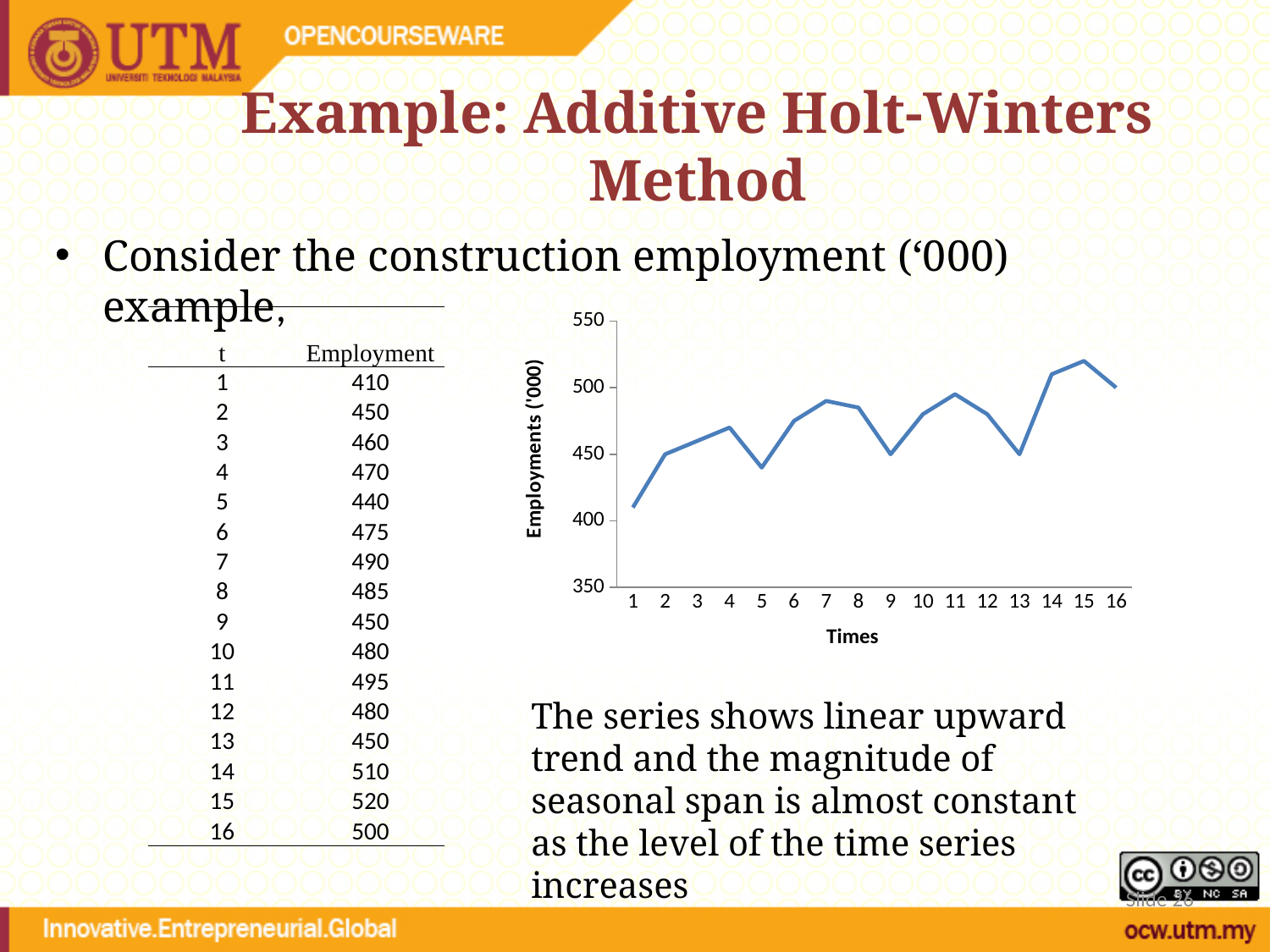
What is the employment value at t = 1? 410 Which has the larger employment value, t = 7 or t = 5? t = 7 Is the value at t = 15 greater or less than 500? greater How many time points are plotted on the chart? 16 What is the difference between the employment value at t = 15 and at t = 1? 110 Is the value at t = 1 greater or less than 450? less What is the label on the vertical axis of the chart? Employments ('000) At which time t does the employment series have its lowest value? 1 Overall, does the employment series rise or fall from t = 1 to t = 16? rise What is the employment value at t = 15? 520 At which time t does the employment series reach its highest value? 15 What kind of chart is shown on the slide? line chart